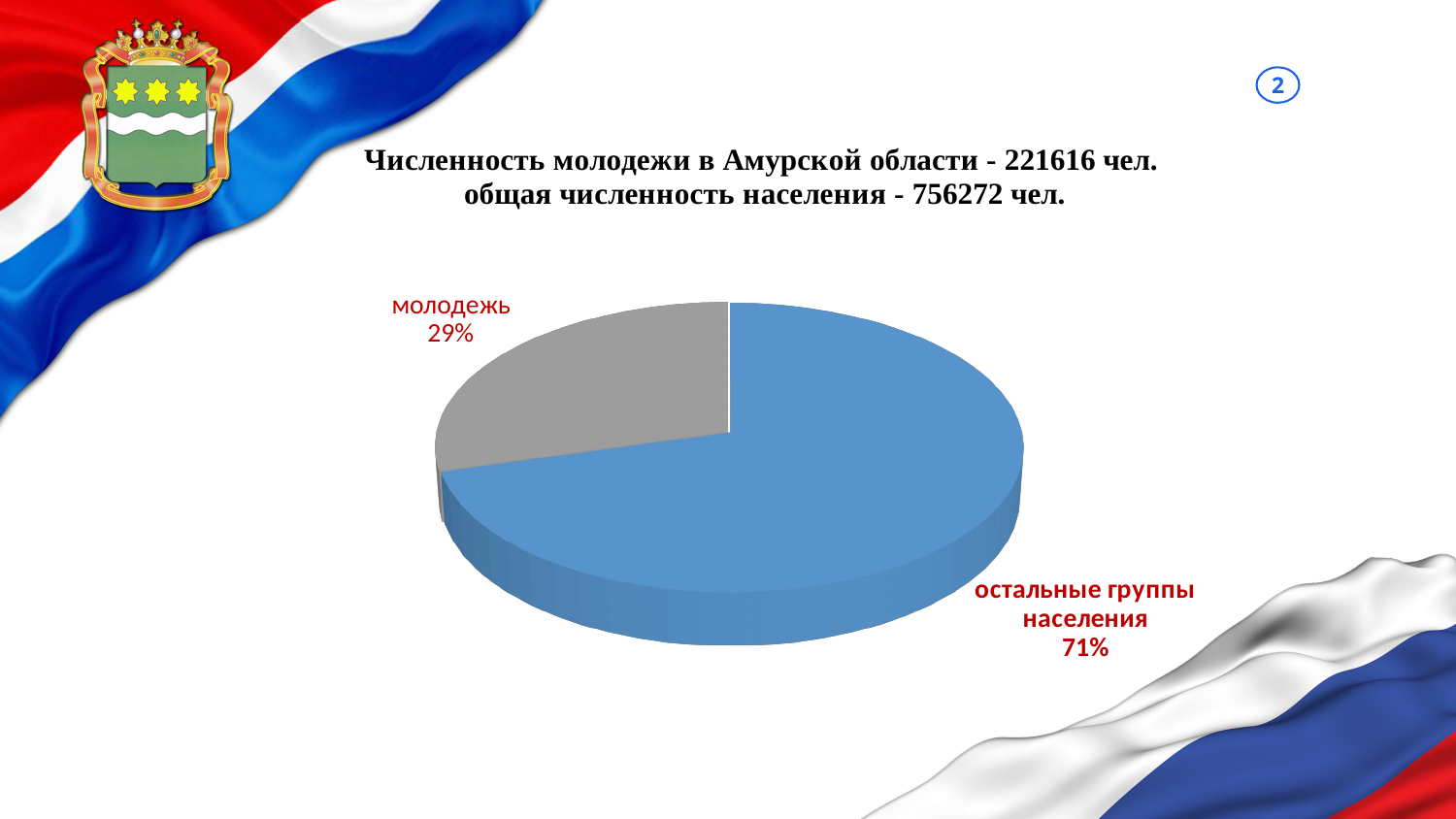
What is the difference in percentage points between the "остальные группы населения" slice and the "молодежь" slice? 42 What colour is the "остальные группы населения" slice? blue Which slice of the pie is the smallest? молодежь How many slices does the pie chart have? 2 What share of the pie does the "остальные группы населения" slice represent? 71% What colour is the "молодежь" slice? grey Which slice of the pie is the largest? остальные группы населения What share of the pie does the "молодежь" slice represent? 29% What kind of chart is shown on the slide? pie chart Which is larger: the "молодежь" slice or the "остальные группы населения" slice? остальные группы населения